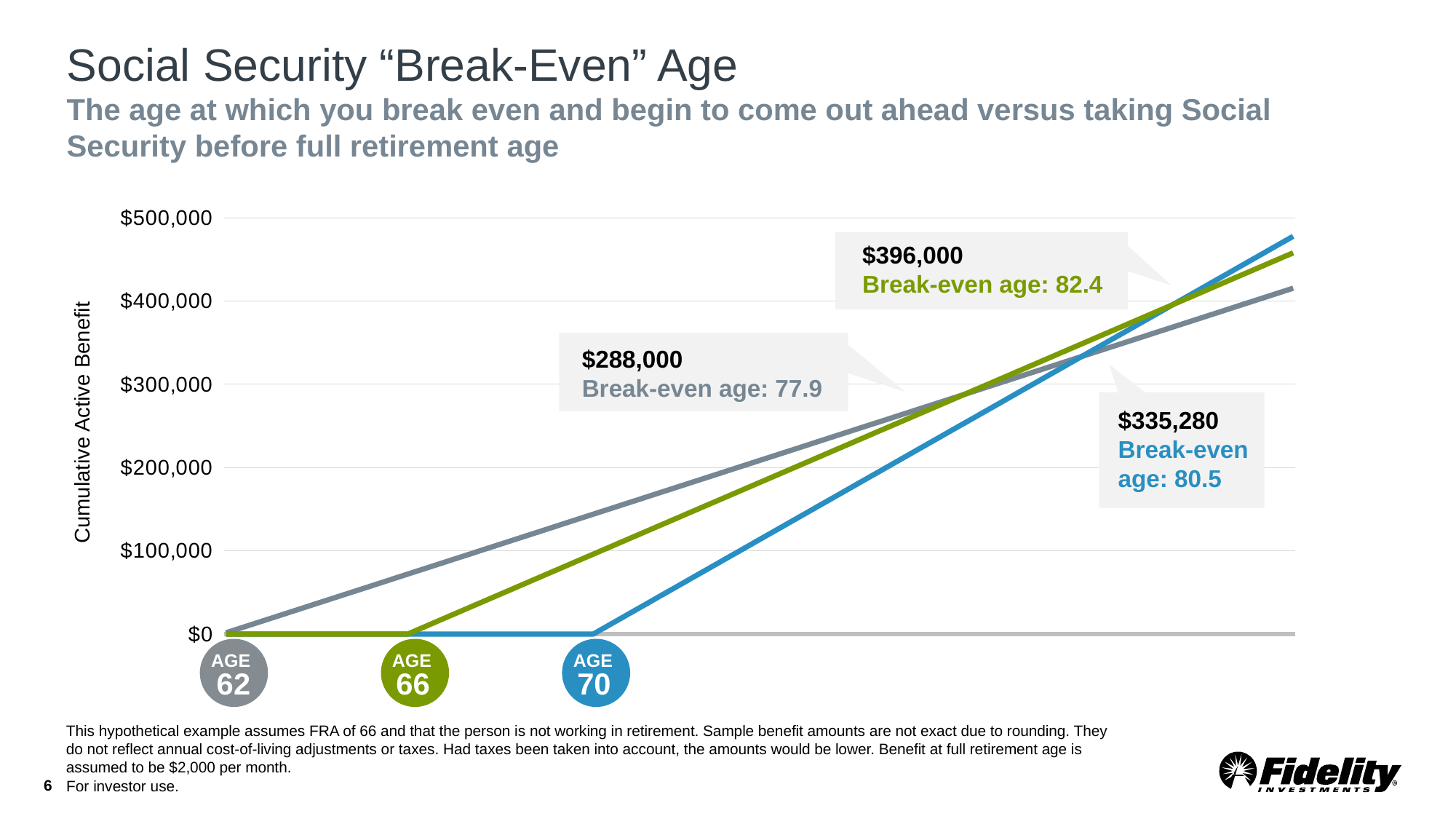
Which is larger, the break-even amount at age 80.5 or the break-even amount at age 77.9? the break-even amount at age 80.5 ($335,280) Which line is highest at the right edge of the chart: Age 62, Age 66 or Age 70? Age 70 Do the lines rise or fall as age increases along the x axis? rise How many lines are plotted on the chart? 3 What cumulative benefit amount is shown in the callout for break-even age 80.5? $335,280 What is the label of the vertical axis? Cumulative Active Benefit What kind of chart is shown on the slide? line chart What is the break-even age shown in the callout for $288,000? 77.9 Which break-even age shown in the callouts is the highest? 82.4 Which break-even age shown in the callouts is the lowest? 77.9 What cumulative benefit amount is shown in the callout for break-even age 82.4? $396,000 What is the difference between the $396,000 and $288,000 break-even amounts? $108,000